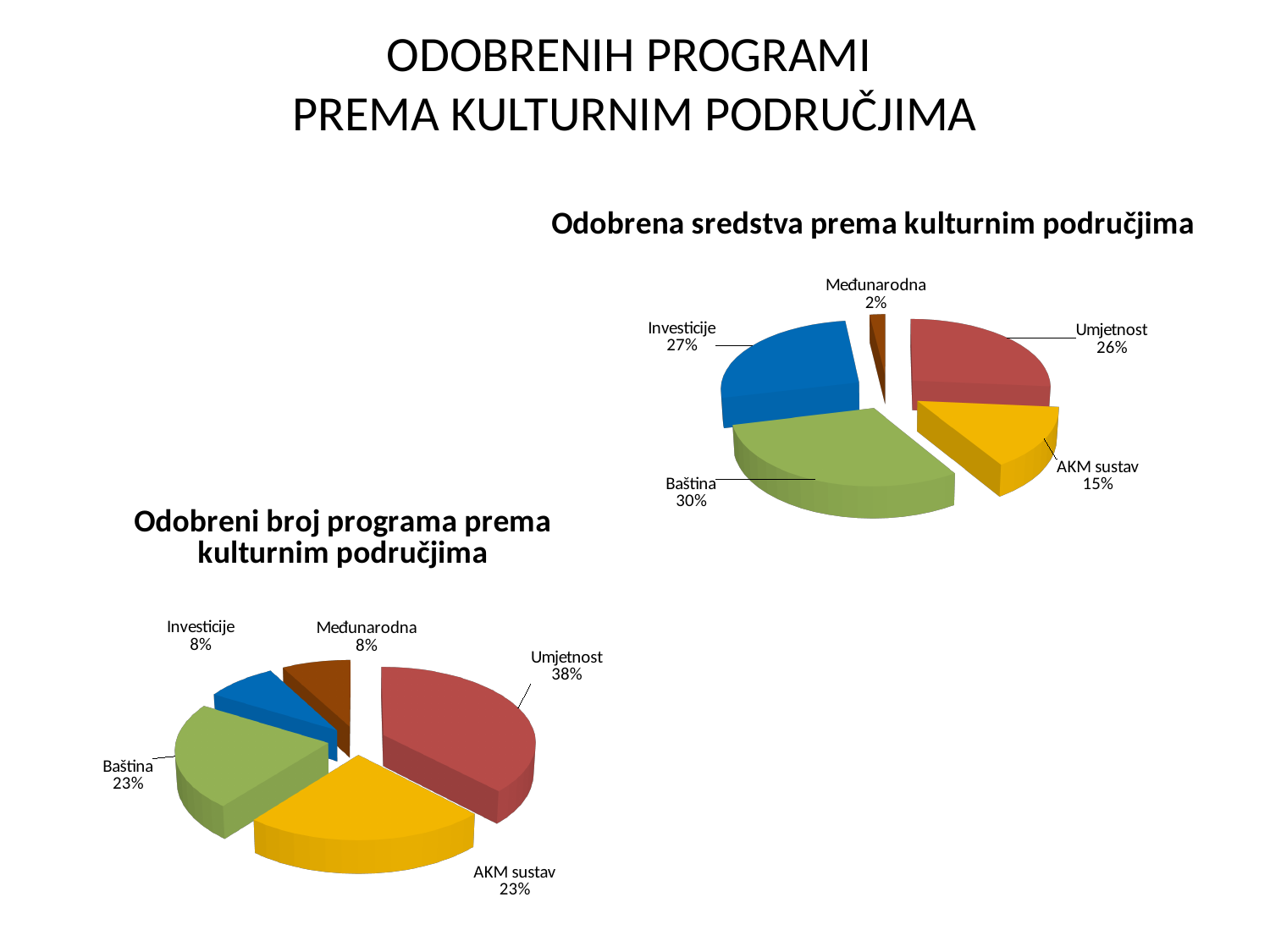
In the chart titled "Odobrena sredstva prema kulturnim područjima", what colour is the Investicije slice? Blue What kind of chart is the chart titled "Odobreni broj programa prema kulturnim područjima"? Pie chart In the chart titled "Odobrena sredstva prema kulturnim područjima", which category has the largest slice? Baština In the chart titled "Odobreni broj programa prema kulturnim područjima", which category has the largest slice? Umjetnost In the chart titled "Odobrena sredstva prema kulturnim područjima", which category has the smallest slice? Međunarodna In the chart titled "Odobrena sredstva prema kulturnim područjima", what share does Međunarodna have? 2% In the chart titled "Odobreni broj programa prema kulturnim područjima", what share does Umjetnost have? 38% In the chart titled "Odobreni broj programa prema kulturnim područjima", which is larger, Baština or Investicije? Baština In the chart titled "Odobrena sredstva prema kulturnim područjima", what share does Baština have? 30% In the chart titled "Odobrena sredstva prema kulturnim područjima", what is the difference in percentage points between Investicije and AKM sustav? 12 In the chart titled "Odobrena sredstva prema kulturnim područjima", how many categories are shown? 5